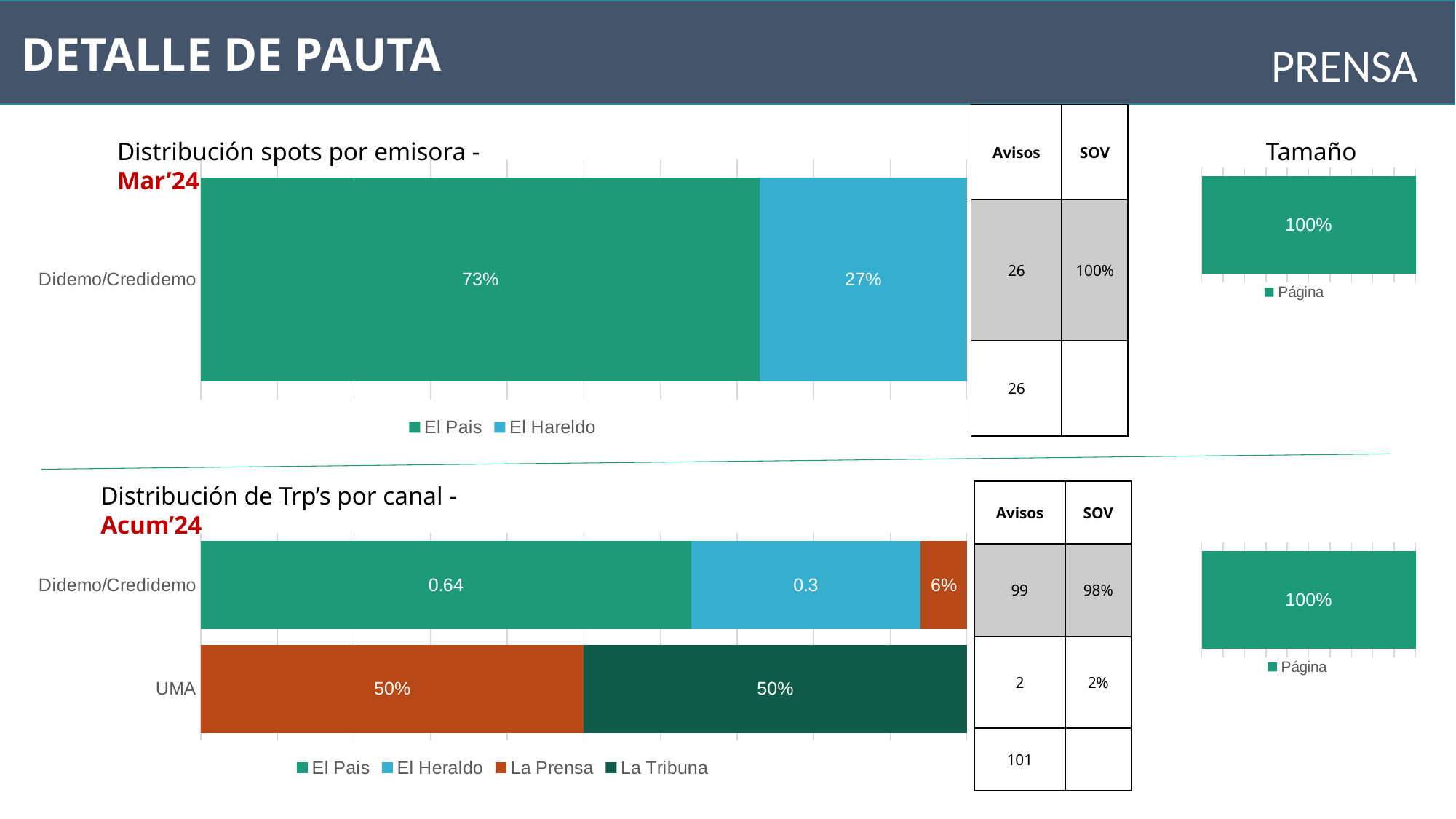
In the 'Distribución spots por emisora - Mar'24' chart, what is the value for El Hareldo for Didemo/Credidemo? 27% In the 'Distribución de Trp's por canal - Acum'24' chart, what is the value for La Prensa for Didemo/Credidemo? 6% In the 'Tamaño' chart at the top right, what value is shown for Página? 100% How many series does the legend of the 'Distribución de Trp's por canal - Acum'24' chart list? 4 How many series does the legend of the 'Distribución spots por emisora - Mar'24' chart list? 2 In the 'Distribución spots por emisora - Mar'24' chart, which series has the larger share for Didemo/Credidemo, El Pais or El Hareldo? El Pais How many categories are shown on the y axis of the 'Distribución de Trp's por canal - Acum'24' chart? 2 What kind of chart is the 'Distribución de Trp's por canal - Acum'24' chart? Bar chart In the 'Distribución de Trp's por canal - Acum'24' chart, what is the value for El Pais for Didemo/Credidemo? 0.64 In the 'Distribución de Trp's por canal - Acum'24' chart, what is the value for La Tribuna for UMA? 50% In the 'Distribución spots por emisora - Mar'24' chart, what is the difference between the El Pais and El Hareldo values for Didemo/Credidemo? 46% In the 'Distribución spots por emisora - Mar'24' chart, what is the value for El Pais for Didemo/Credidemo? 73%